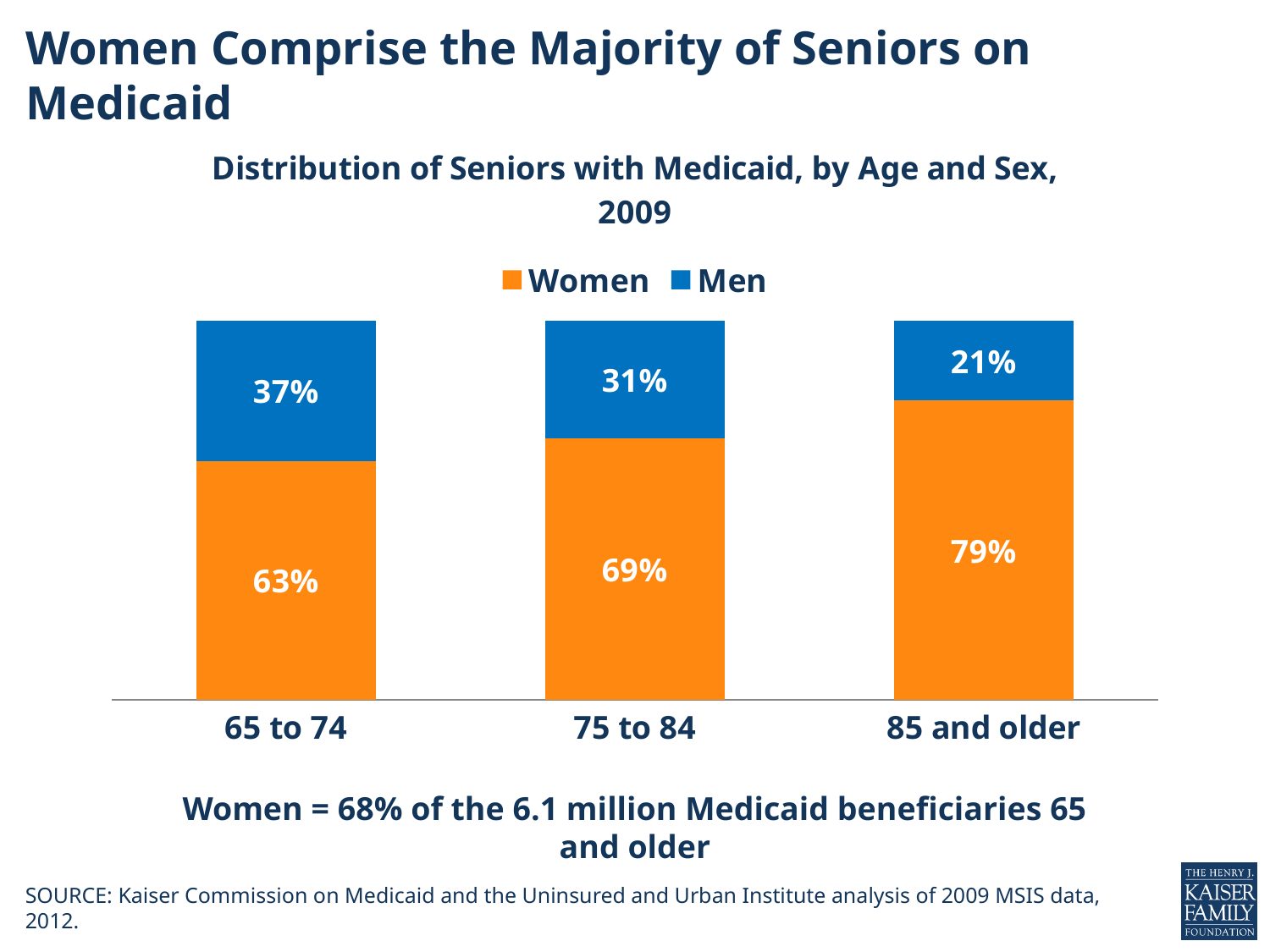
How many series does the legend list? 2 Does the share of women rise or fall as age group increases along the x axis? Rise What is the difference between the Women and Men shares in the 75 to 84 age group? 38 percentage points Which colour represents Women in the chart? Orange Is the share of women larger in the 65 to 74 group or the 85 and older group? 85 and older What kind of chart is shown on the slide? Stacked bar chart How many age groups are shown on the x axis? 3 Which age group has the lowest share of men? 85 and older What percentage of Medicaid seniors aged 65 to 74 are women? 63% What percentage of Medicaid seniors aged 85 and older are men? 21% Which age group has the highest share of women? 85 and older What is the value for Men in the 75 to 84 age group? 31%